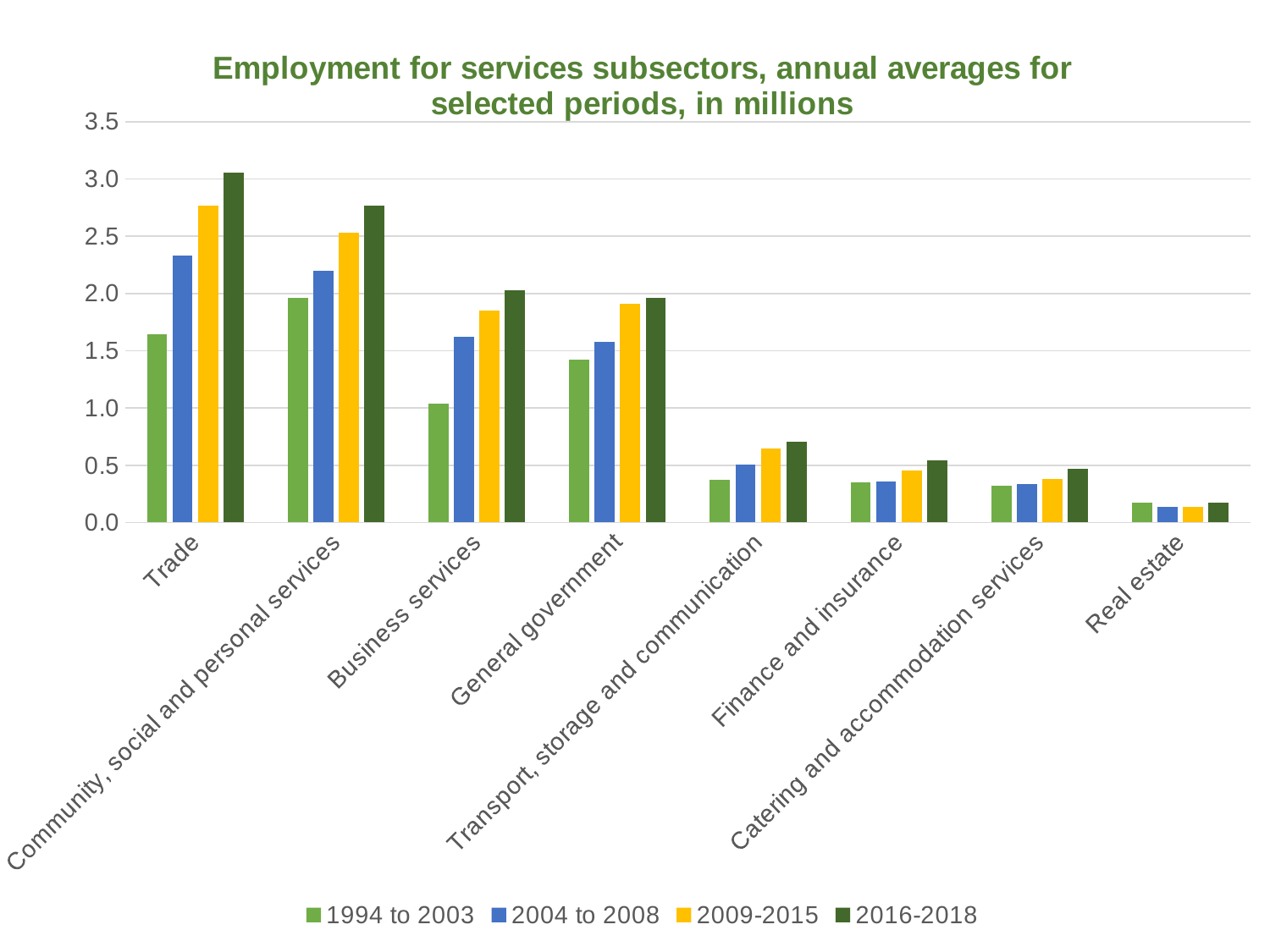
What kind of chart is shown on the slide? bar chart Which subsector has the lowest employment for 2016-2018? Real estate Which subsector has the highest employment for 2016-2018? Trade Is the value for Trade in 1994 to 2003 greater or less than 1.5? greater How many series does the legend list? 4 How many subsector categories are shown on the x axis? 8 Is the value for General government in 2009-2015 greater or less than 2.0? less Is the value for Finance and insurance in 1994 to 2003 greater or less than 0.5? less Which is larger for 2016-2018: Trade or Community, social and personal services? Trade For Trade, do the values rise or fall from the 1994 to 2003 period to the 2016-2018 period? rise What is the title of the chart? Employment for services subsectors, annual averages for selected periods, in millions